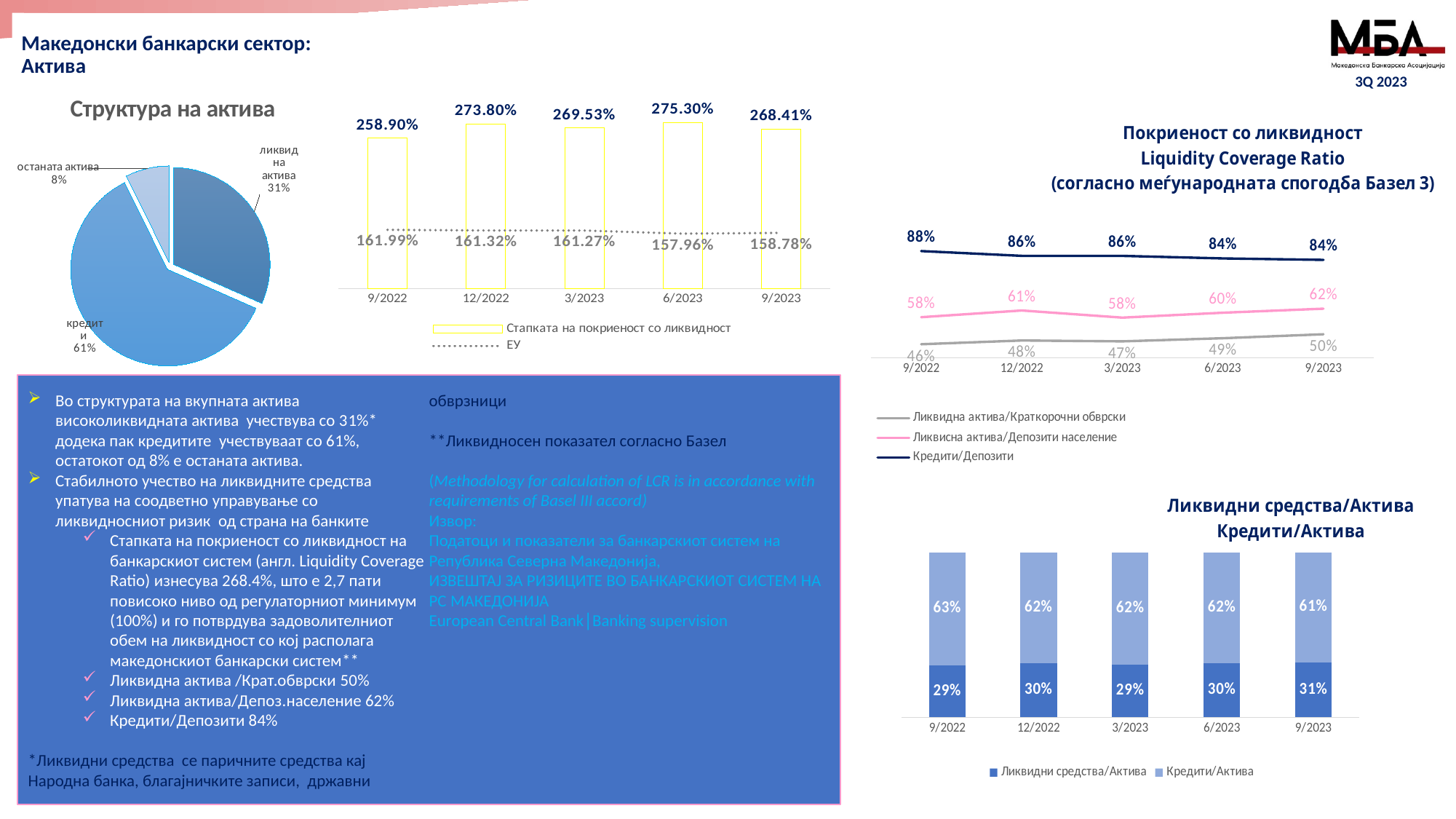
What type of chart is 'Ликвидни средства/Актива Кредити/Актива'? stacked bar chart In the chart 'Покриеност со ликвидност Liquidity Coverage Ratio', what is the value of 'Кредити/Депозити' for 9/2022? 88% In the chart 'Покриеност со ликвидност Liquidity Coverage Ratio', does the 'Ликвидна актива/Краткорочни обврски' series rise or fall from 9/2022 to 9/2023? rise In the pie chart 'Структура на актива', what share does 'кредити' have? 61% In the pie chart 'Структура на актива', what share does 'останата актива' have? 8% In the chart 'Покриеност со ликвидност Liquidity Coverage Ratio', how many series does the legend list? 3 In the bar chart with the 'Стапката на покриеност со ликвидност' legend, what is the value for 6/2023? 275.30% In the bar chart with the 'Стапката на покриеност со ликвидност' legend, which period has the lowest bar value? 9/2022 In the stacked bar chart 'Ликвидни средства/Актива Кредити/Актива', what is the value of 'Ликвидни средства/Актива' for 9/2023? 31% In the chart 'Покриеност со ликвидност Liquidity Coverage Ratio', what is the difference between 'Кредити/Депозити' and 'Ликвисна актива/Депозити население' for 9/2023? 22% In the bar chart with the 'Стапката на покриеност со ликвидност' legend, what is the 'ЕУ' value for 9/2023? 158.78% In the pie chart 'Структура на актива', how many slices are there? 3